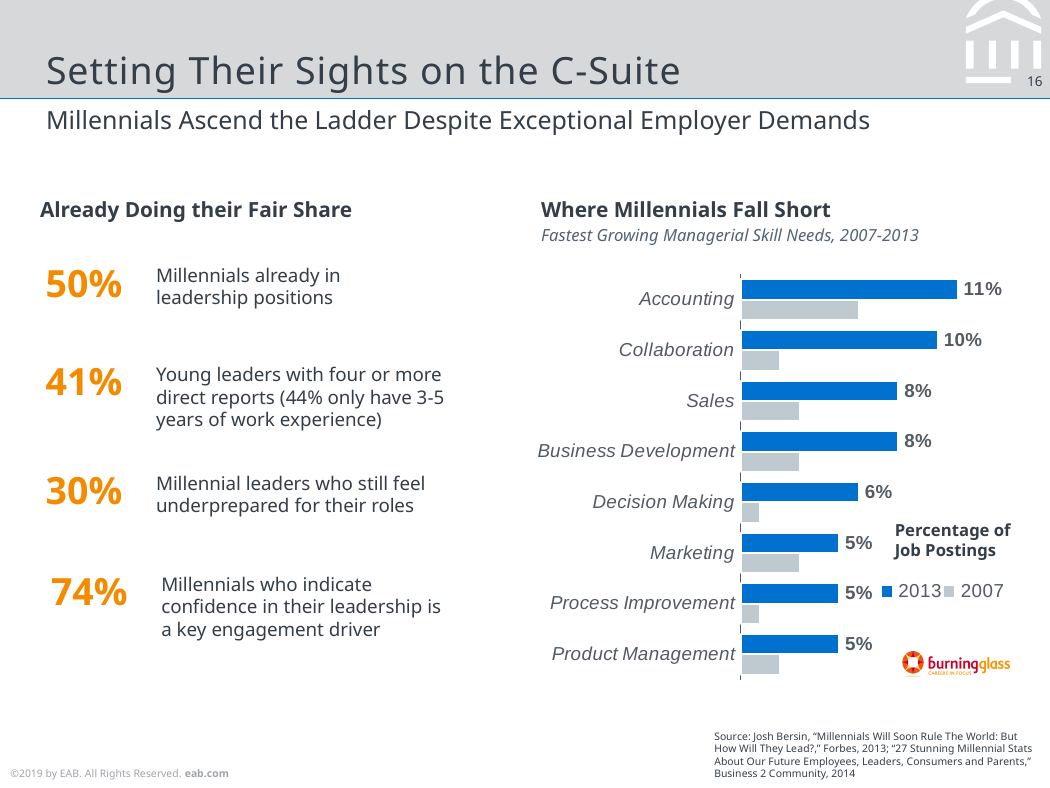
How many series does the legend list? 2 Which category has the highest 2013 value? Accounting What is the difference between the 2013 values for Accounting and Sales? 3% What is the 2013 value for Business Development? 8% What is the difference between the 2013 values for Collaboration and Marketing? 5% What is the 2013 value for Decision Making? 6% How many categories are shown in the chart? 8 What kind of chart is shown on the slide? Bar chart Which has the larger 2013 value, Sales or Decision Making? Sales What is the 2013 value for Collaboration? 10% What is the 2013 value for Accounting? 11% For Accounting, which series has the larger bar, 2013 or 2007? 2013